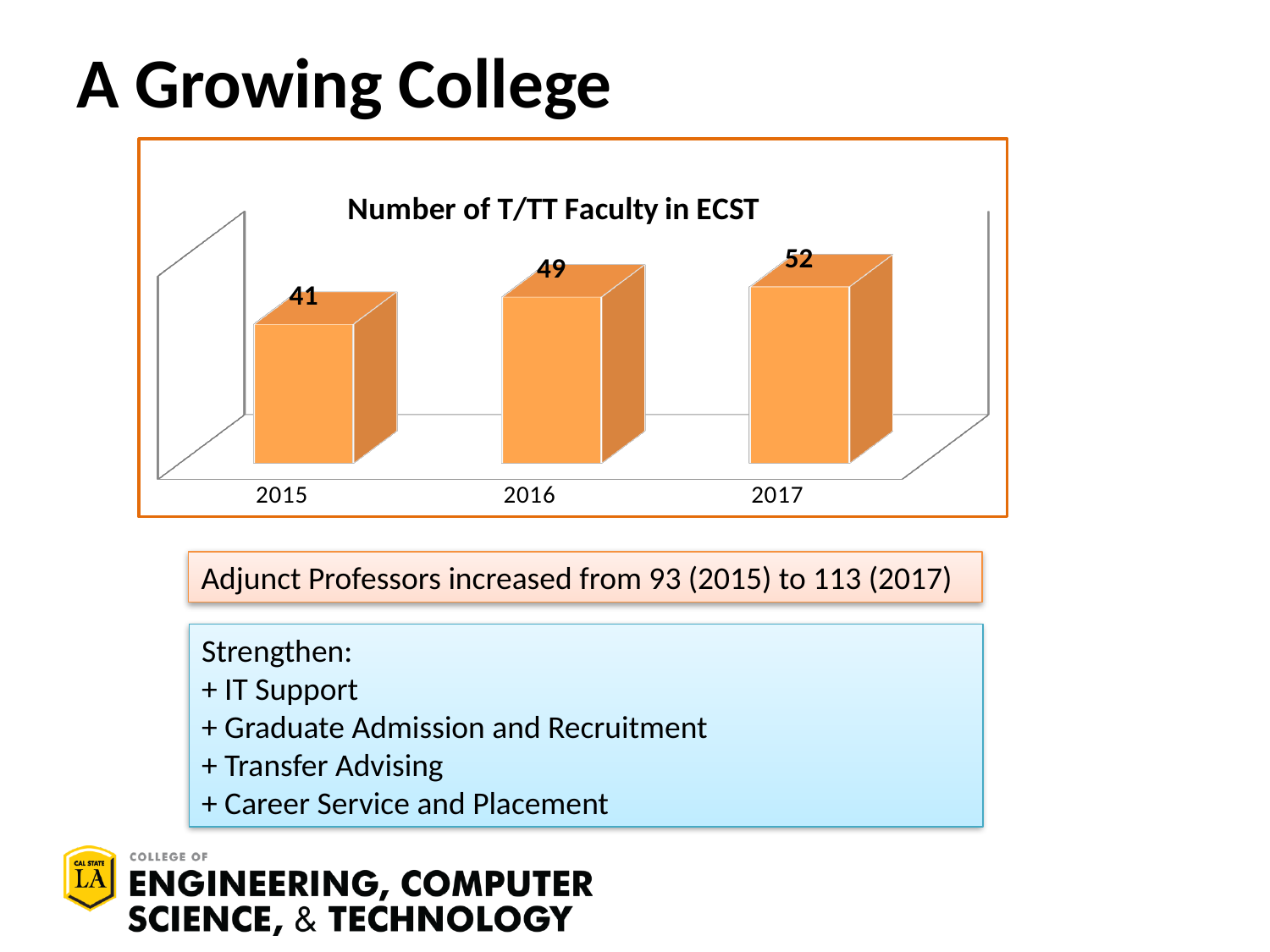
What is the number of T/TT faculty in ECST in 2017? 52 Does the number of T/TT faculty rise or fall from 2015 to 2017? Rise What is the title of the chart? Number of T/TT Faculty in ECST By how much did the number of T/TT faculty increase from 2015 to 2017? 11 What is the difference in T/TT faculty between 2016 and 2015? 8 Which year has more T/TT faculty, 2016 or 2017? 2017 What is the number of T/TT faculty in ECST in 2016? 49 How many years are shown on the chart? 3 What kind of chart is used to show the number of T/TT faculty? Bar chart Which year has the highest number of T/TT faculty? 2017 Which year has the lowest number of T/TT faculty? 2015 What is the number of T/TT faculty in ECST in 2015? 41